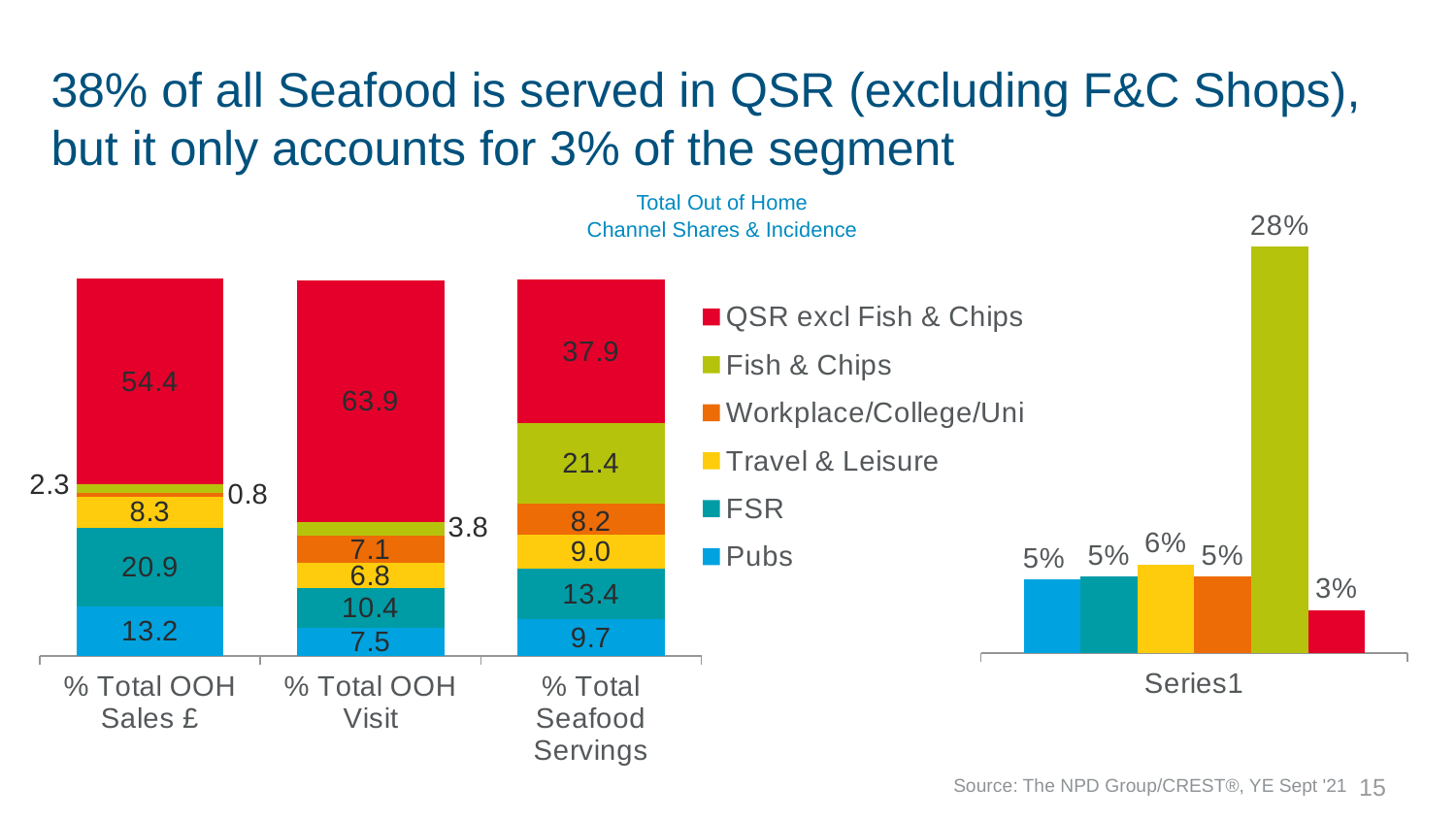
How many series does the legend of the stacked bar chart titled 'Total Out of Home Channel Shares & Incidence' list? 6 In the stacked bar chart titled 'Total Out of Home Channel Shares & Incidence', what is the value for QSR excl Fish & Chips in the '% Total OOH Visit' bar? 63.9 In the stacked bar chart titled 'Total Out of Home Channel Shares & Incidence', which category has the largest QSR excl Fish & Chips segment? % Total OOH Visit What type of chart is the chart on the right of the slide, labelled 'Series1'? Bar chart How many categories are shown on the x axis of the stacked bar chart titled 'Total Out of Home Channel Shares & Incidence'? 3 In the stacked bar chart titled 'Total Out of Home Channel Shares & Incidence', what is the difference between the FSR values for '% Total OOH Sales £' and '% Total OOH Visit'? 10.5 In the bar chart on the right of the slide labelled 'Series1', what is the lowest value shown? 3% In the bar chart on the right of the slide labelled 'Series1', what is the highest value shown? 28% In the stacked bar chart titled 'Total Out of Home Channel Shares & Incidence', which is larger: Travel & Leisure in '% Total Seafood Servings' or Travel & Leisure in '% Total OOH Visit'? % Total Seafood Servings In the stacked bar chart titled 'Total Out of Home Channel Shares & Incidence', what is the value for Fish & Chips in the '% Total Seafood Servings' bar? 21.4 In the stacked bar chart titled 'Total Out of Home Channel Shares & Incidence', what is the value for Workplace/College/Uni in the '% Total OOH Sales £' bar? 0.8 In the stacked bar chart titled 'Total Out of Home Channel Shares & Incidence', what is the value for Pubs in the '% Total OOH Sales £' bar? 13.2